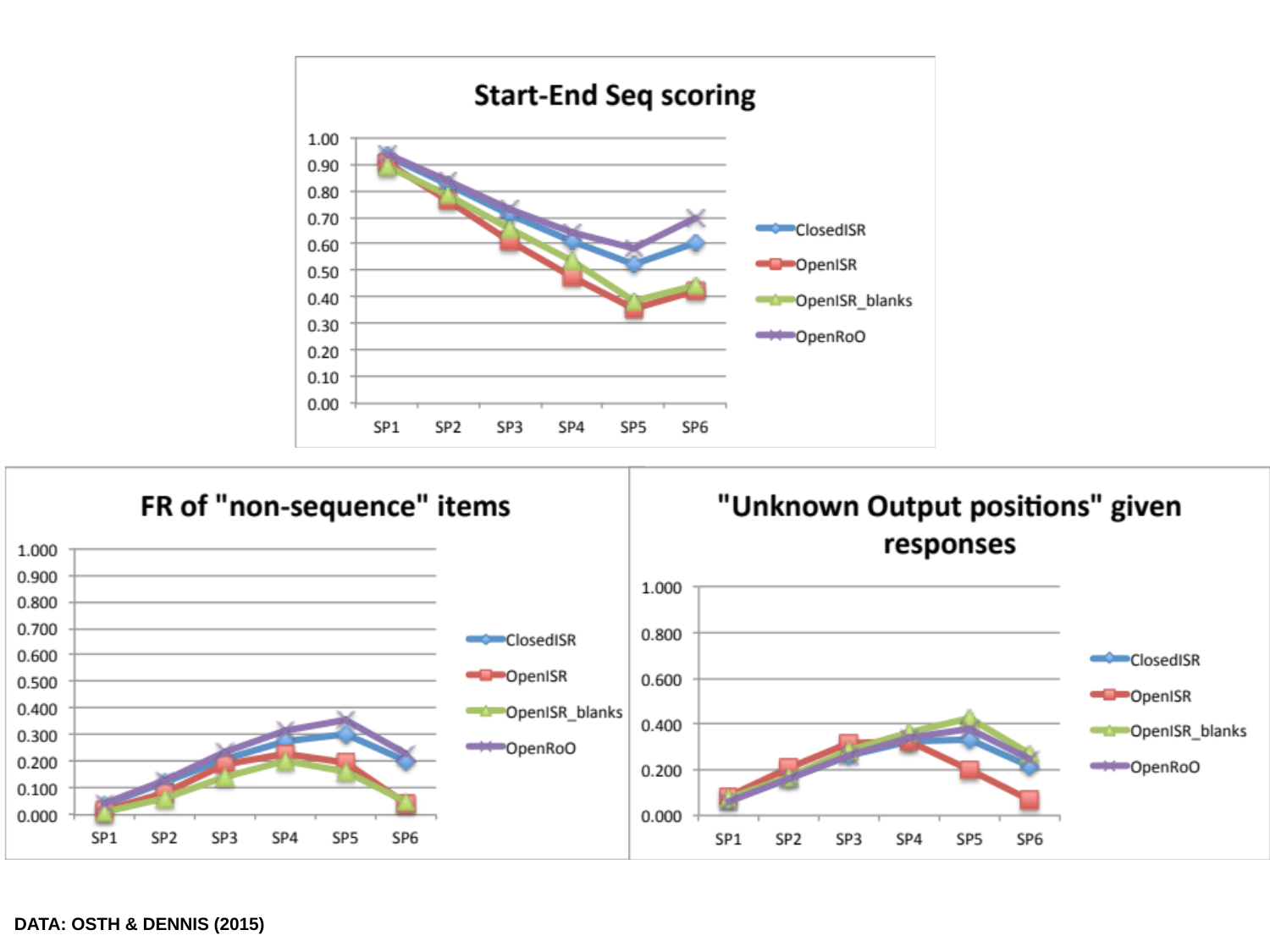
What kind of chart is the "Start-End Seq scoring" chart? line chart In the "Unknown Output positions" given responses chart, which series has the lowest value at SP6? OpenISR How many series does the legend of the "Start-End Seq scoring" chart list? 4 In the "Start-End Seq scoring" chart, which series has the highest value at SP6? OpenRoO In the "FR of "non-sequence" items" chart, is the value for OpenISR at SP6 greater or less than 0.100? less How many serial positions (categories) are shown on the x axis of the "FR of "non-sequence" items" chart? 6 In the "Start-End Seq scoring" chart, which series has the lowest value at SP5? OpenISR In the "Unknown Output positions" given responses chart, which is larger at SP5: ClosedISR or OpenISR? ClosedISR In the "Start-End Seq scoring" chart, is the value for ClosedISR at SP1 greater or less than 0.90? greater In the "FR of "non-sequence" items" chart, which series has the highest value at SP5? OpenRoO In the "Start-End Seq scoring" chart, do the values for OpenISR rise or fall from SP1 to SP5? fall In the "Start-End Seq scoring" chart, is the value for OpenISR at SP5 greater or less than 0.40? less